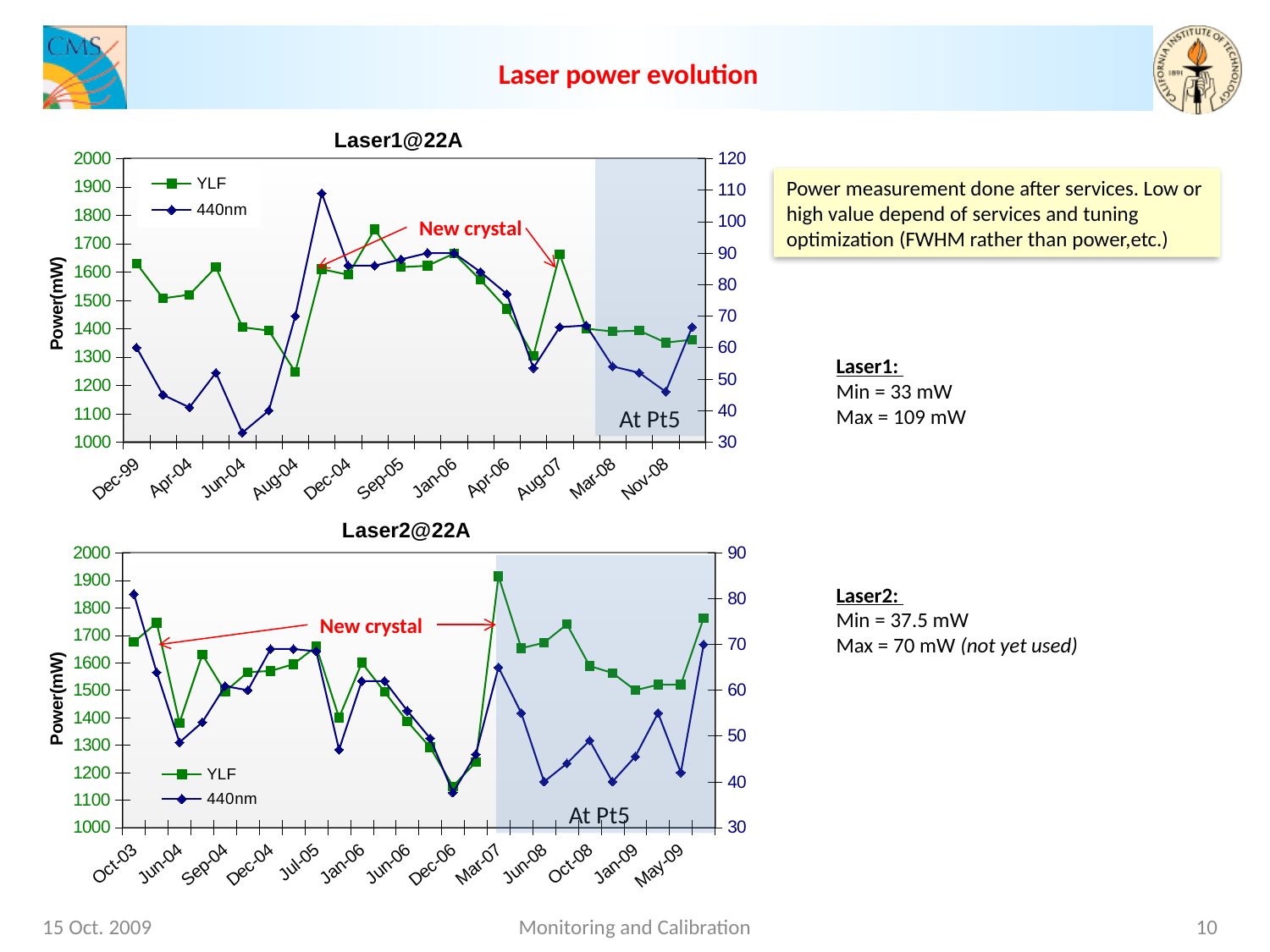
In the Laser2@22A chart, is the YLF value at Mar-07 greater or less than 1800? greater What is the label on the left vertical axis of the Laser2@22A chart? Power(mW) What are the two series named in the legend of the Laser1@22A chart? YLF and 440nm In the Laser2@22A chart, is the YLF value at Dec-06 greater or less than 1200? less How many series does the legend of the Laser2@22A chart list? 2 In the Laser2@22A chart, is the YLF value higher at Oct-03 or at Jun-04? Oct-03 In the Laser1@22A chart, is the YLF value at Aug-04 greater or less than 1300? less In the Laser2@22A chart, at which x-axis date does the YLF series reach its highest value? Mar-07 In the Laser2@22A chart, at which x-axis date does the YLF series reach its lowest value? Dec-06 What type of chart is the Laser1@22A chart? line chart In the Laser2@22A chart, does the YLF series rise or fall between Oct-03 and Jun-04? fall